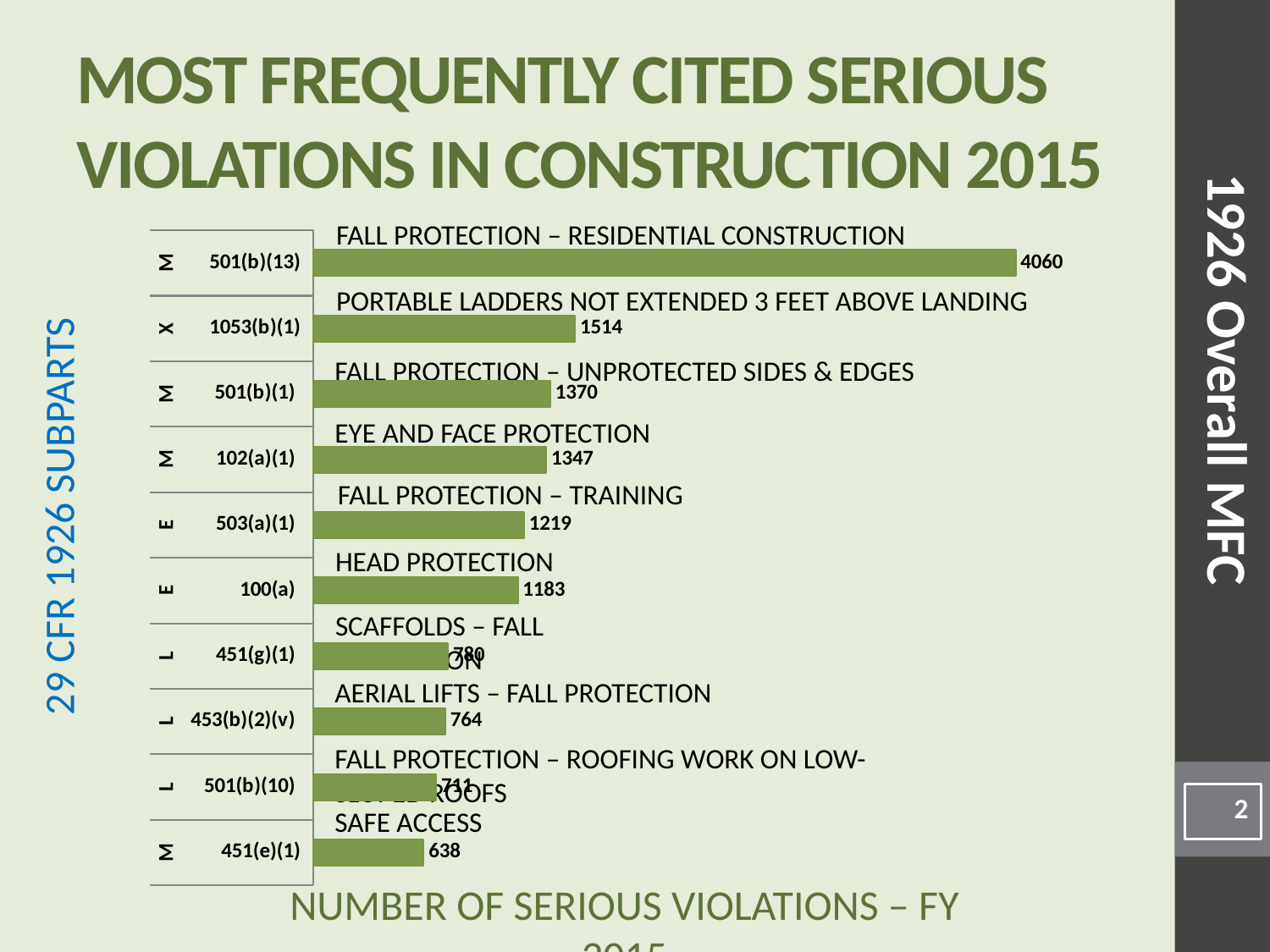
How many categories are plotted in the chart? 10 How many serious violations are shown for 102(a)(1), Eye and Face Protection? 1347 Which has more serious violations, 501(b)(1) Fall Protection – Unprotected Sides & Edges or 503(a)(1) Fall Protection – Training? 501(b)(1) Fall Protection – Unprotected Sides & Edges What is the difference between the values for 501(b)(13) and 1053(b)(1)? 2546 What kind of chart is shown on the slide? bar chart What is the value for 1053(b)(1), Portable Ladders Not Extended 3 Feet Above Landing? 1514 What is the value for 451(e)(1), Safe Access? 638 What is the value for 100(a), Head Protection? 1183 Which category has the lowest number of serious violations? 451(e)(1) Safe Access What is the x-axis title of the chart? Number of Serious Violations – FY 2015 Which category has the highest number of serious violations? 501(b)(13) Fall Protection – Residential Construction How many serious violations are shown for 501(b)(13), Fall Protection – Residential Construction? 4060